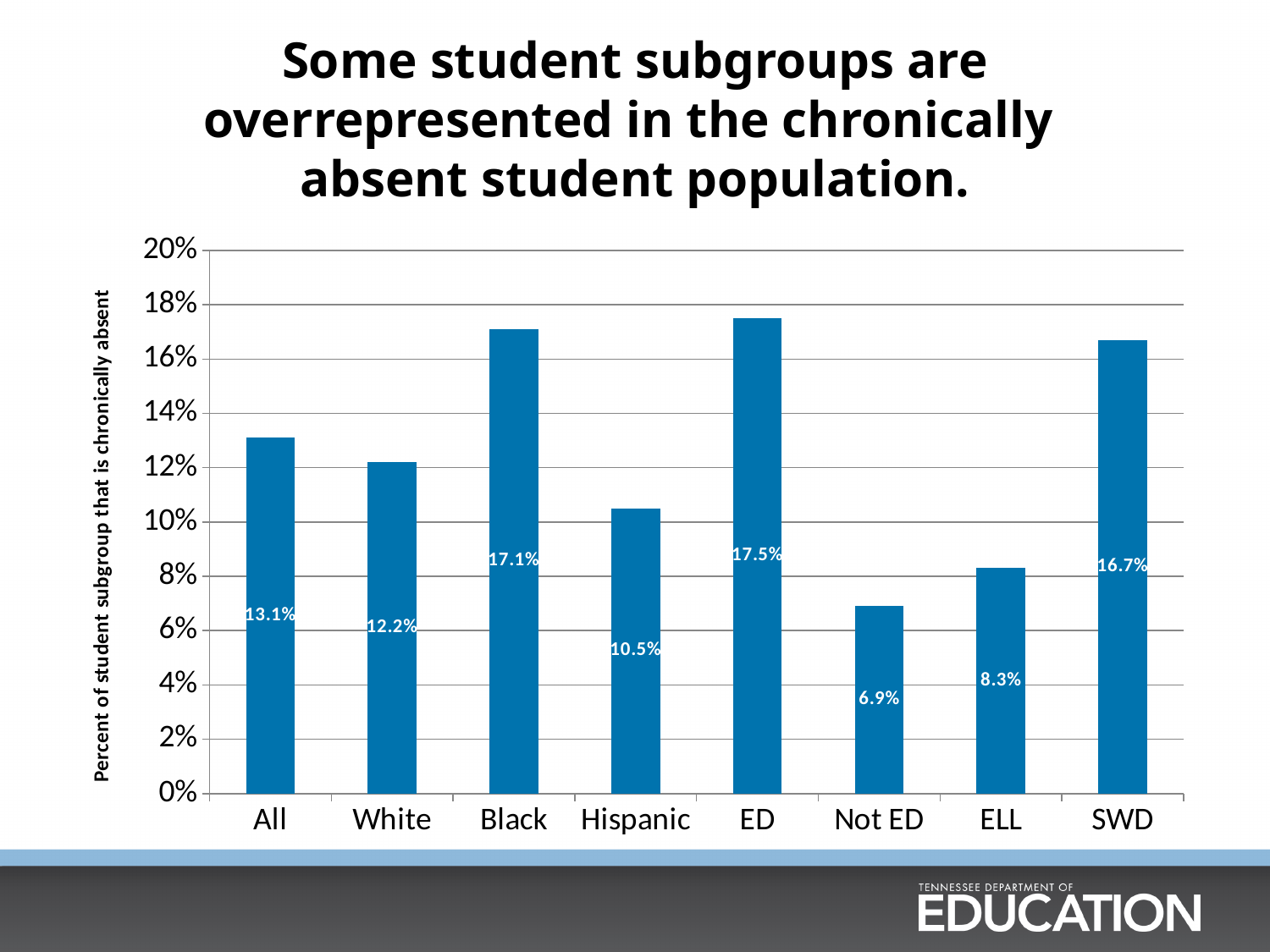
What is the value for the SWD subgroup? 16.7% How many subgroups are shown on the x axis? 8 What is the difference between the ED and Not ED values? 10.6% Which subgroup has the lowest percent chronically absent? Not ED What is the percent of the Black subgroup that is chronically absent? 17.1% Which subgroup has the highest percent chronically absent? ED Is the value for All greater or less than 12%? greater What is the value for the Not ED subgroup? 6.9% What kind of chart is shown on the slide? bar chart What is the difference between the Black and White values? 4.9% Which is larger, the value for Hispanic or the value for ELL? Hispanic What is the label of the vertical axis? Percent of student subgroup that is chronically absent